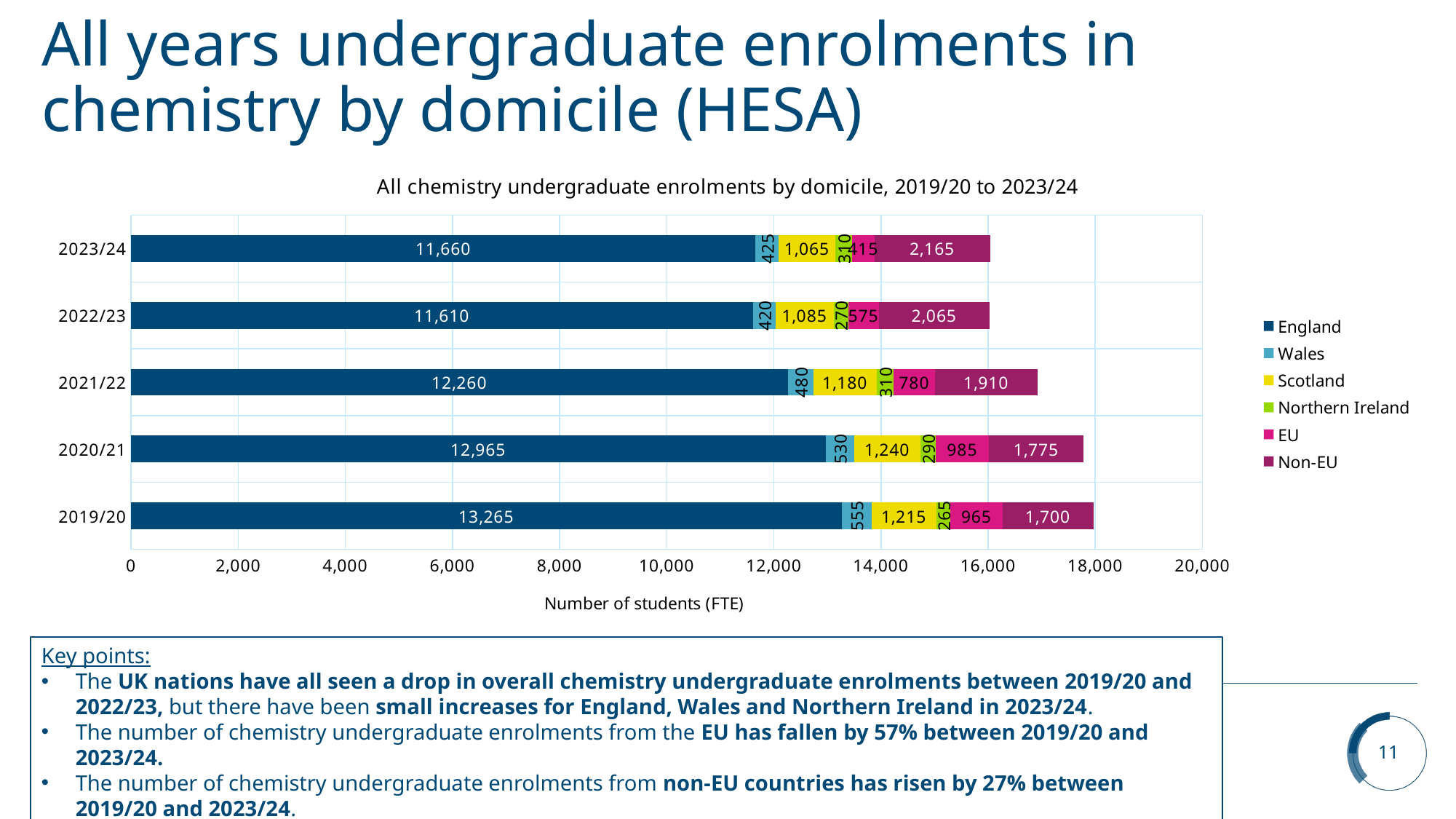
What is the label on the x axis? Number of students (FTE) What is the total of the stacked bar for 2019/20? 17,965 What is the England value for 2023/24? 11,660 How many series does the legend list? 6 How many academic years are shown on the chart? 5 Which year has the highest England value? 2019/20 Which is larger, the Scotland value for 2020/21 or the Scotland value for 2022/23? 2020/21 Which year has the lowest EU value? 2023/24 What type of chart is shown on the slide? Stacked bar chart What is the EU value for 2021/22? 780 What is the difference between the EU values for 2019/20 and 2023/24? 550 What is the Non-EU value for 2019/20? 1,700